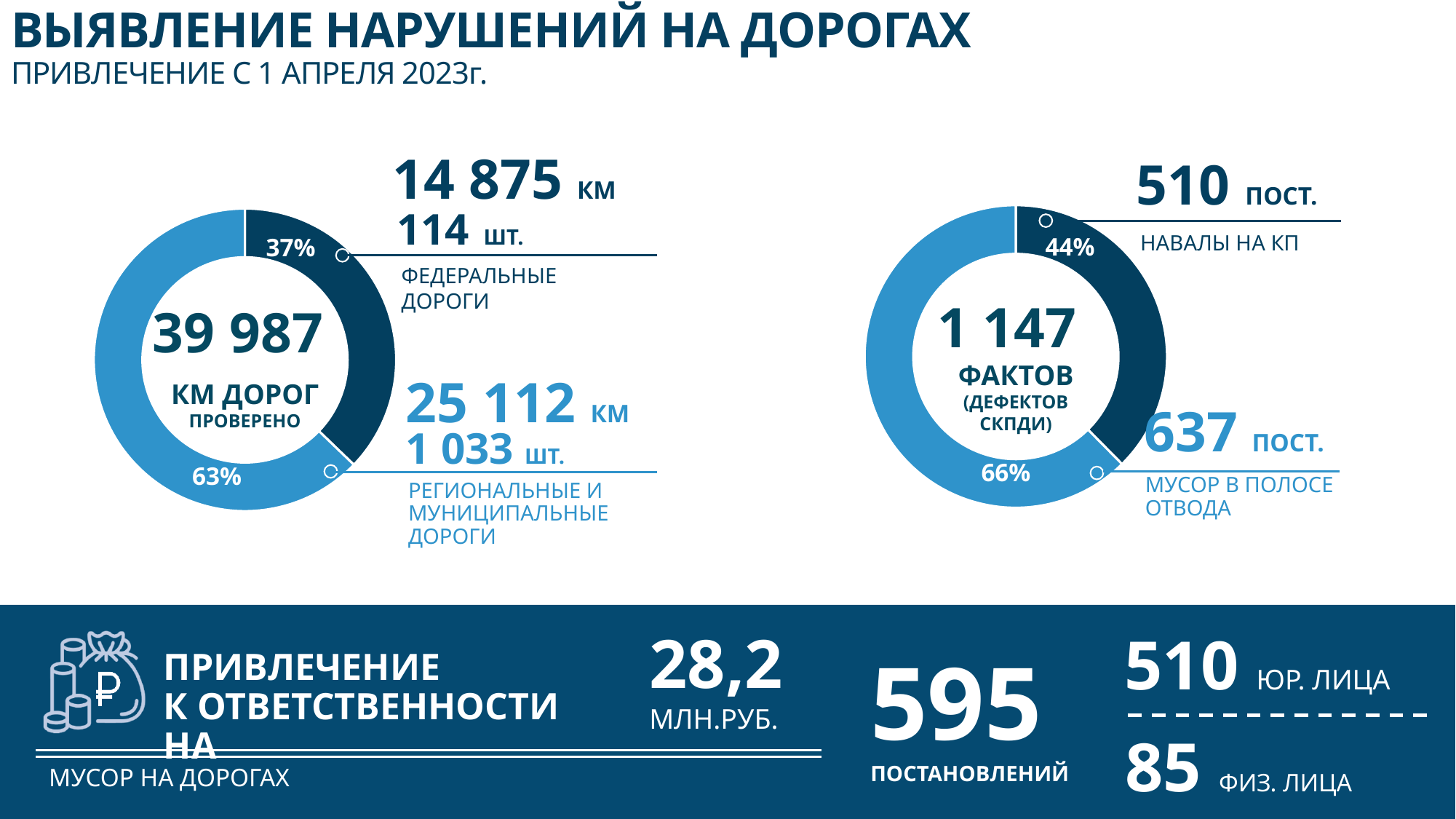
What total is shown in the centre of the left donut chart? 39 987 км дорог проверено In the left donut chart, how many km are shown for федеральные дороги? 14 875 км In the left donut chart, what is the difference in km between региональные и муниципальные дороги and федеральные дороги? 10 237 км What kind of chart is the left chart on the slide? Donut (pie) chart How many segments does the right donut chart have? 2 In the left donut chart, what share is shown for федеральные дороги? 37% What total is shown in the centre of the right donut chart? 1 147 фактов In the left donut chart, how many km are shown for региональные и муниципальные дороги? 25 112 км In the left donut chart, which category has the larger share: федеральные дороги or региональные и муниципальные дороги? Региональные и муниципальные дороги In the right donut chart, how many постановлений are shown for мусор в полосе отвода? 637 пост. In the left donut chart, what share is shown for региональные и муниципальные дороги? 63% In the right donut chart, what share is shown for навалы на КП? 44%